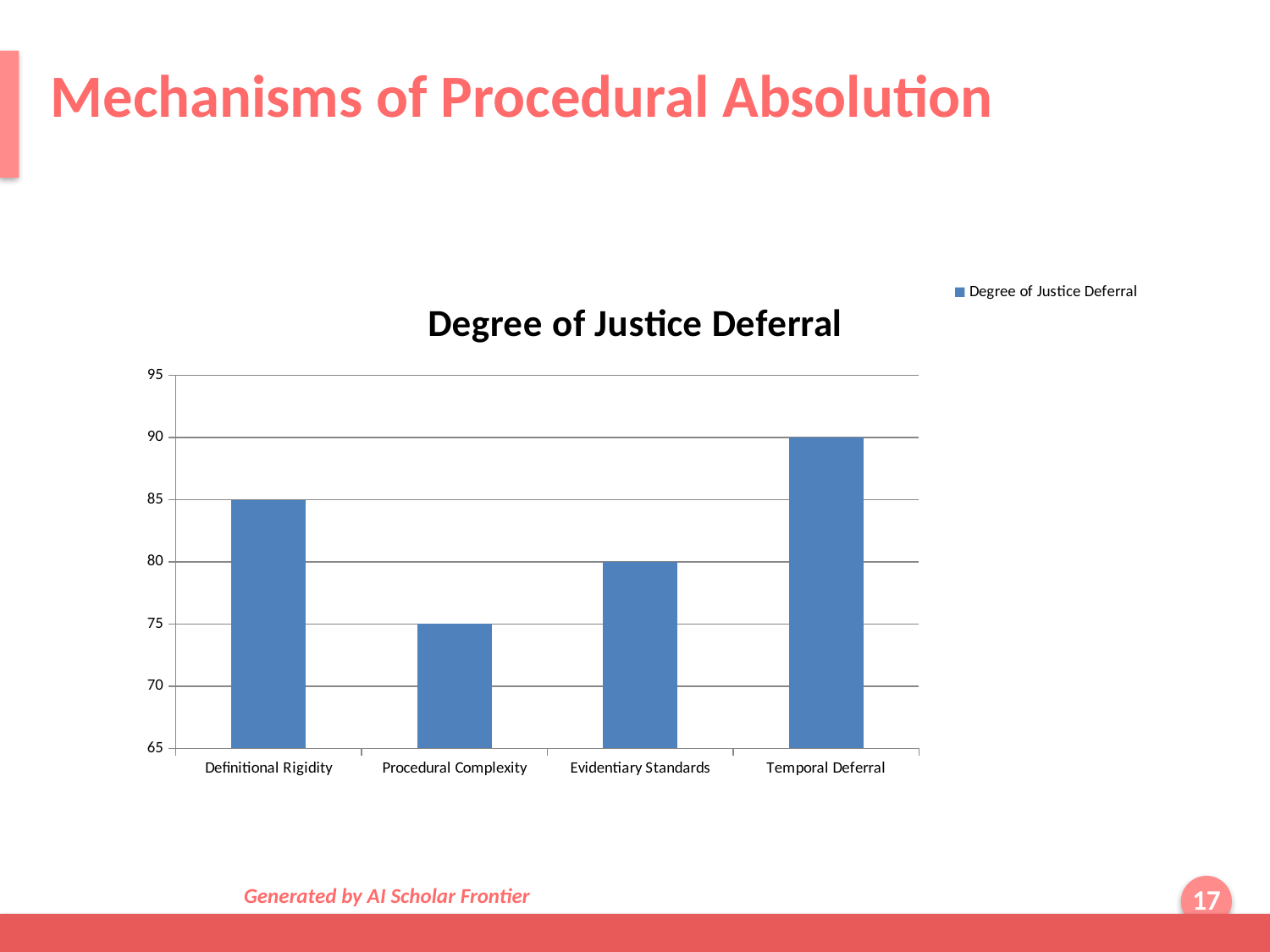
Which category has the highest Degree of Justice Deferral? Temporal Deferral What is the value for Procedural Complexity? 75 How many series does the legend list? 1 Is the value for Evidentiary Standards greater or less than 85? less What is the value for Temporal Deferral? 90 What is the title of the chart? Degree of Justice Deferral What is the difference between the values for Temporal Deferral and Procedural Complexity? 15 Which is larger, the value for Definitional Rigidity or the value for Evidentiary Standards? Definitional Rigidity How many categories are shown on the x axis? 4 What kind of chart is shown on the slide? bar chart What is the value for Definitional Rigidity? 85 Which category has the lowest Degree of Justice Deferral? Procedural Complexity